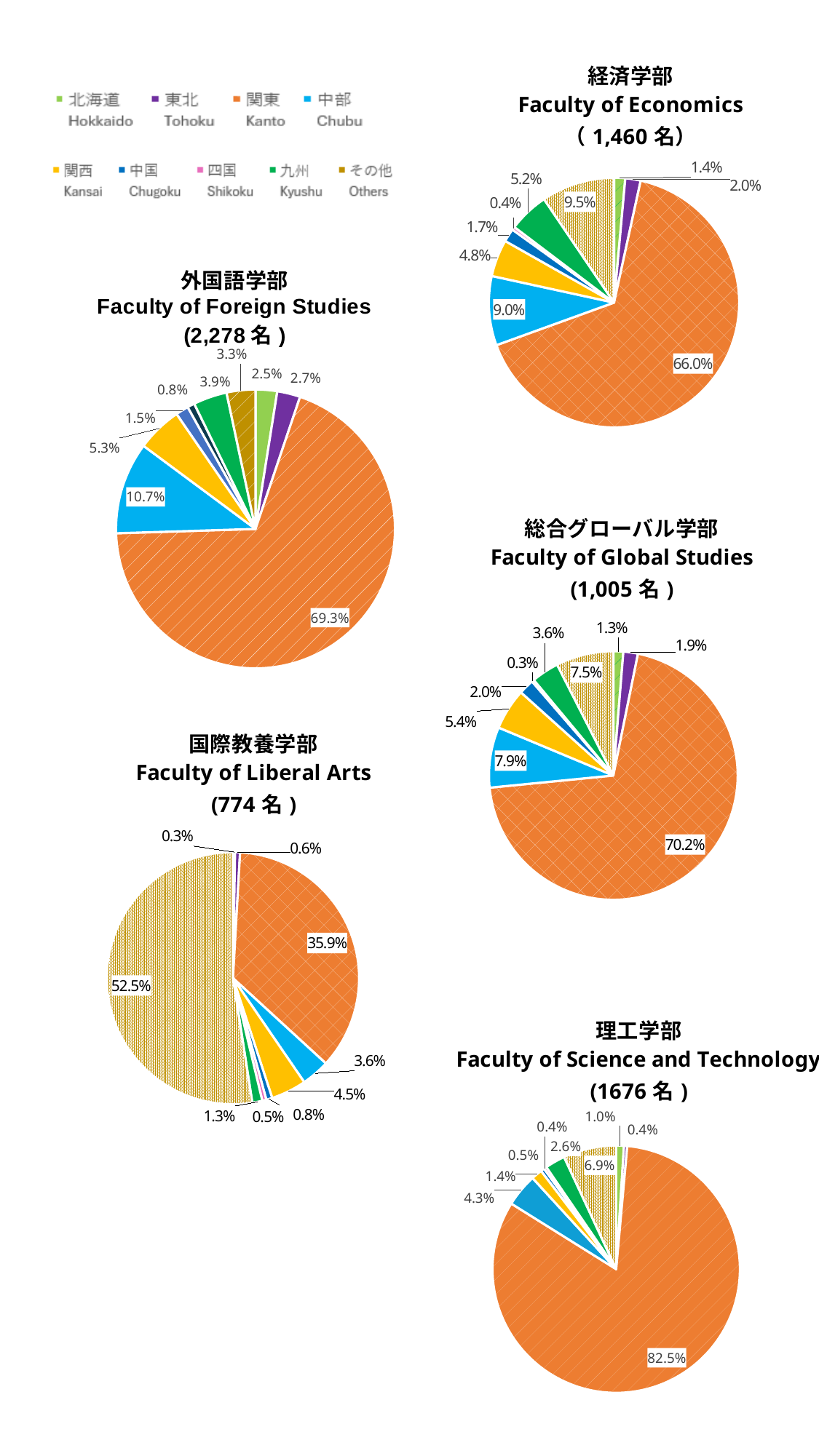
What kind of charts are shown on the slide? Pie charts In the Faculty of Liberal Arts chart, which is larger, the Kanto slice or the Others slice? Others How many students does the Faculty of Economics chart cover, according to its title? 1,460 In the Faculty of Foreign Studies chart, what share is Kanto? 69.3% In the Faculty of Foreign Studies chart, what is the difference between the Kanto share and the Chubu share? 58.6% In the Faculty of Economics chart, what share is Chubu? 9.0% In the Faculty of Science and Technology chart, what share is Kanto? 82.5% In the Faculty of Global Studies chart, which region has the largest share? Kanto How many pie charts are on the slide? 5 How many regions does the legend list? 9 In the Faculty of Global Studies chart, what share is Chubu? 7.9% In the Faculty of Liberal Arts chart, what share is Others? 52.5%